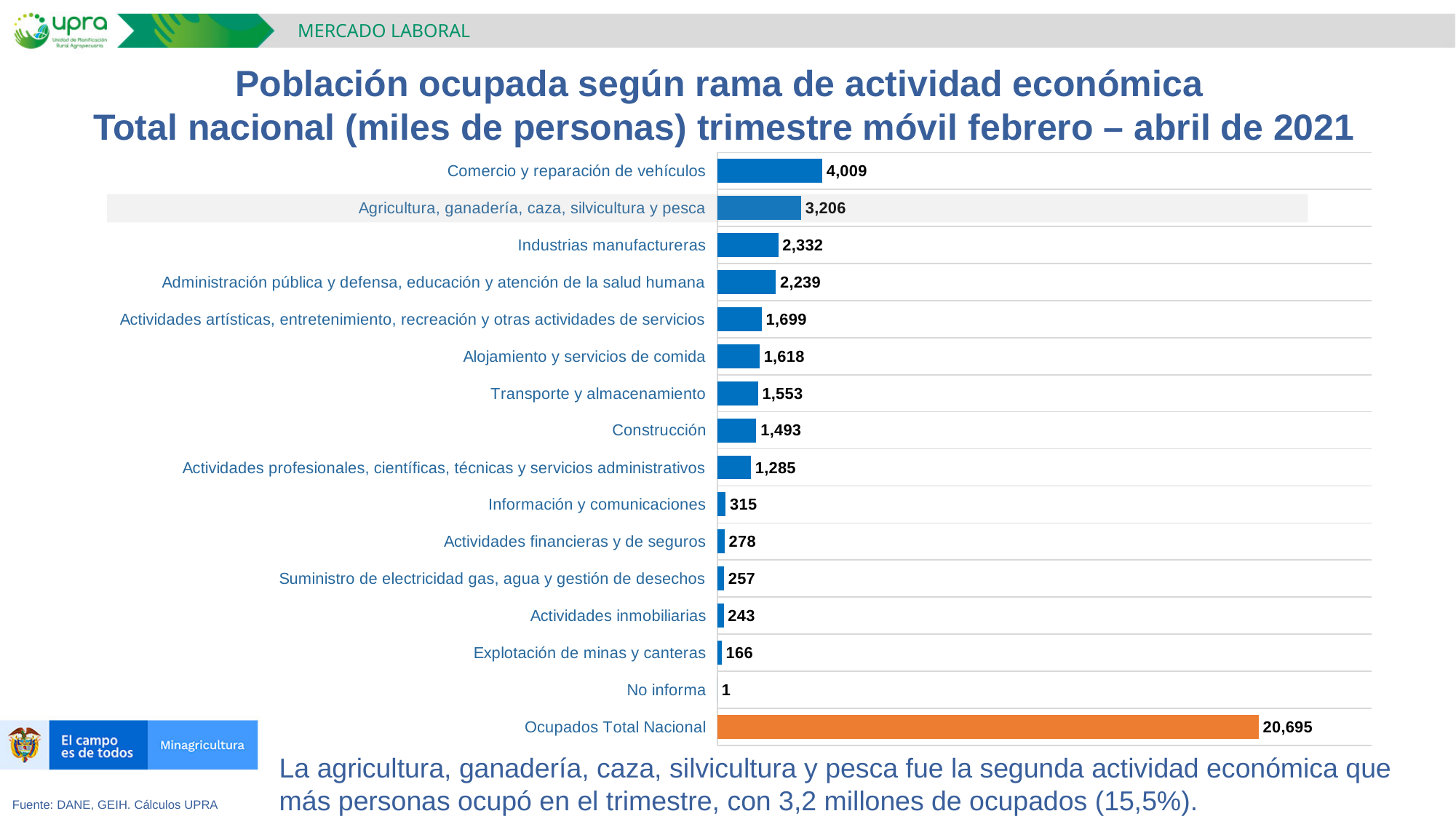
What is the value shown for Ocupados Total Nacional? 20,695 What is the value for Industrias manufactureras? 2,332 What is the difference between the values for Comercio y reparación de vehículos and Agricultura, ganadería, caza, silvicultura y pesca? 803 What is the value for Agricultura, ganadería, caza, silvicultura y pesca? 3,206 Which is larger, the value for Transporte y almacenamiento or the value for Construcción? Transporte y almacenamiento What colour is the bar for Ocupados Total Nacional? Orange Which category has the lowest value on the chart? No informa Excluding the national total bar, which economic activity has the highest value? Comercio y reparación de vehículos What is the value for Explotación de minas y canteras? 166 What is the difference between the values for Información y comunicaciones and Actividades financieras y de seguros? 37 What kind of chart is shown on the slide? Bar chart How many bars are shown on the chart, including the national total? 16